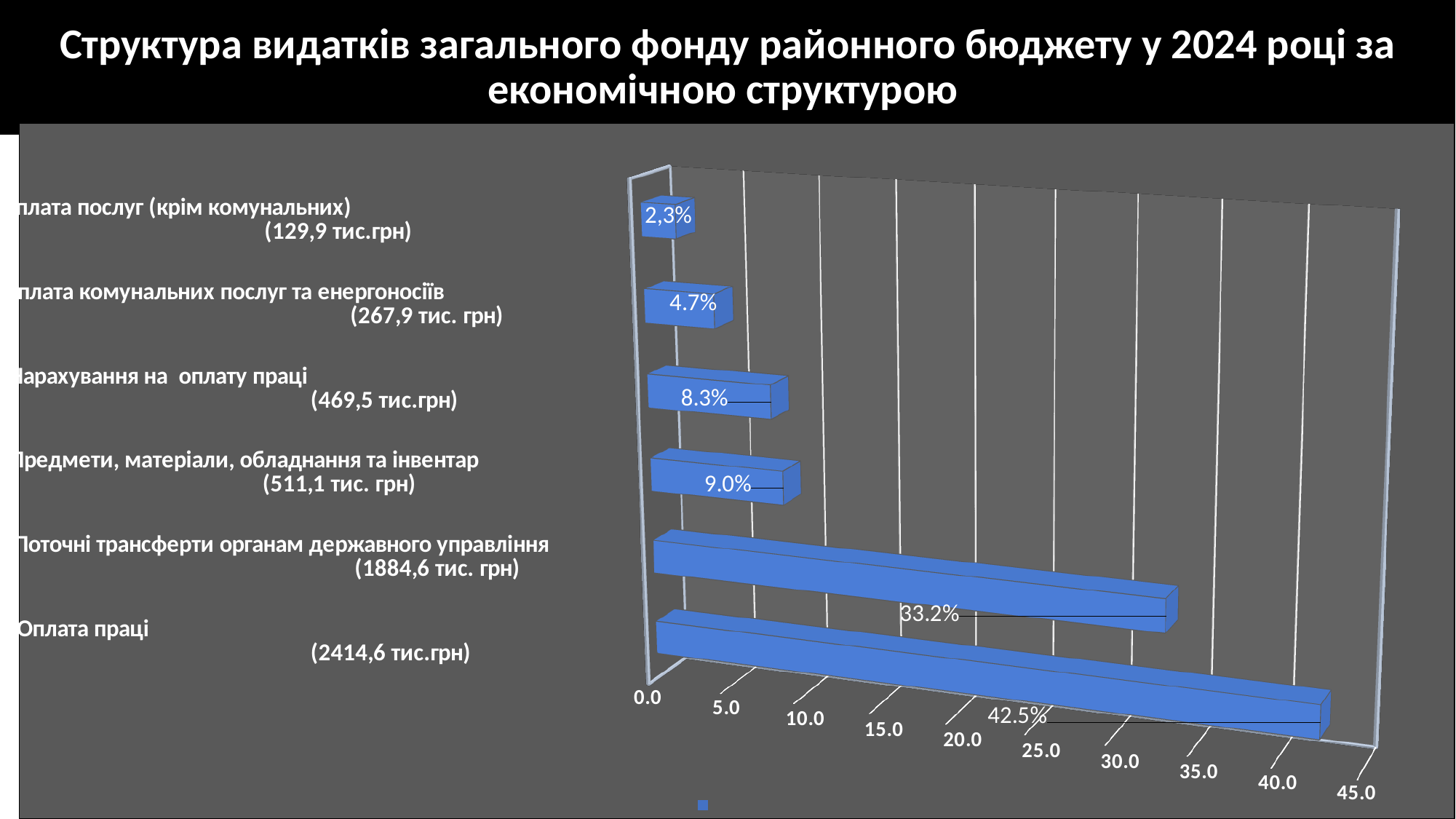
What percentage is shown for Оплата комунальних послуг та енергоносіїв? 4.7% What is the title of the slide? Структура видатків загального фонду районного бюджету у 2024 році за економічною структурою What is the difference in percentage points between Оплата праці and Поточні трансферти органам державного управління? 9.3 How many categories are shown in the chart? 6 Which category has the smallest share of expenditures? Оплата послуг (крім комунальних) What percentage is shown for Оплата праці? 42.5% What percentage is shown for Поточні трансферти органам державного управління? 33.2% Which is larger: the share for Предмети, матеріали, обладнання та інвентар or the share for Нарахування на оплату праці? Предмети, матеріали, обладнання та інвентар What percentage is shown for Нарахування на оплату праці? 8.3% What percentage is shown for Предмети, матеріали, обладнання та інвентар? 9.0% Which category has the largest share of expenditures? Оплата праці What type of chart is shown on the slide? Bar chart